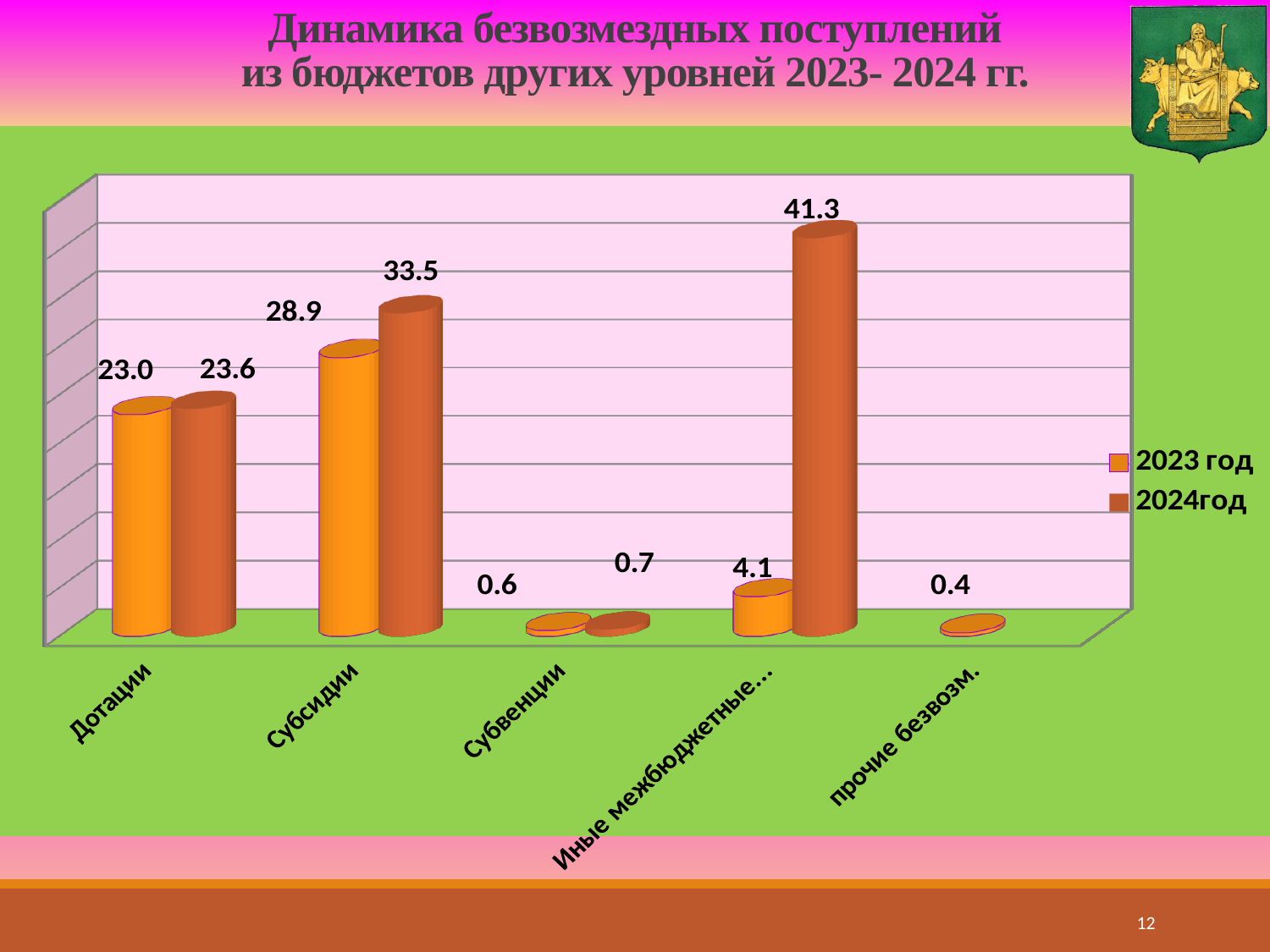
How many series does the legend list? 2 Which is larger for Субсидии: the 2023 год value or the 2024год value? 2024год What is the difference between the 2024год and 2023 год values for Иные межбюджетные...? 37.2 Which category has the highest value in the 2024год series? Иные межбюджетные... What is the value for Субсидии in the 2024год series? 33.5 What type of chart is shown on the slide? bar chart What is the value for Иные межбюджетные... in the 2024год series? 41.3 How many categories are shown on the x axis? 5 Which category has the lowest value in the 2023 год series? прочие безвозм. What is the value for прочие безвозм. in the 2023 год series? 0.4 What is the value for Субвенции in the 2023 год series? 0.6 What is the value for Дотации in the 2023 год series? 23.0